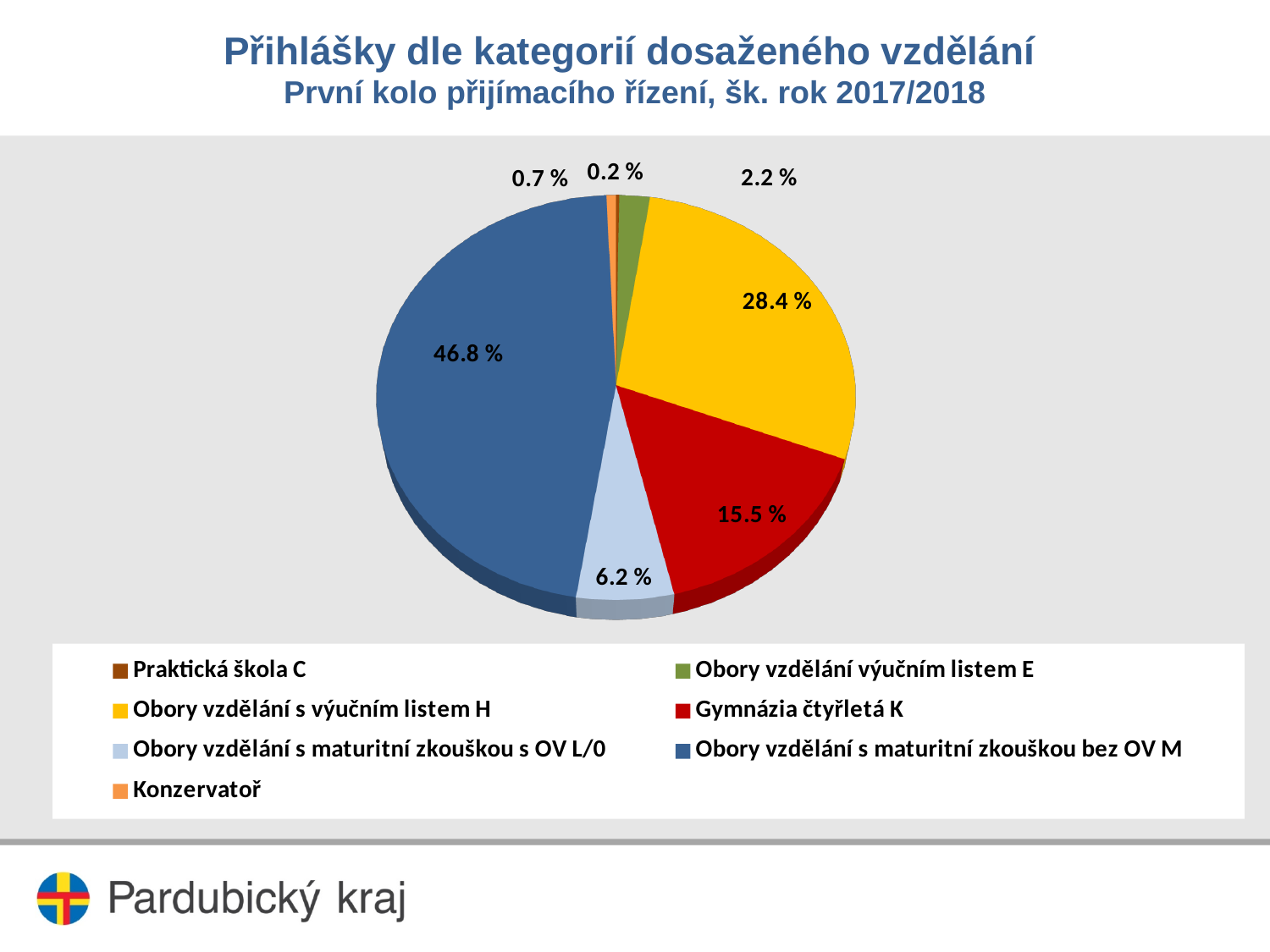
How many categories does the legend list? 7 What is the difference in percentage points between Obory vzdělání s výučním listem H and Gymnázia čtyřletá K? 12.9 What share of applications is for Gymnázia čtyřletá K? 15.5 % What share of applications is for Obory vzdělání s maturitní zkouškou s OV L/0? 6.2 % Which category has the largest share of applications? Obory vzdělání s maturitní zkouškou bez OV M Which category has the smallest share of applications? Praktická škola C What share of applications is for Obory vzdělání s výučním listem H? 28.4 % Which has a larger share, Gymnázia čtyřletá K or Obory vzdělání s maturitní zkouškou s OV L/0? Gymnázia čtyřletá K What colour is the slice for Gymnázia čtyřletá K? red What share of applications is for Konzervatoř? 0.7 % What share of applications is for Obory vzdělání s maturitní zkouškou bez OV M? 46.8 % What type of chart is shown on the slide? pie chart